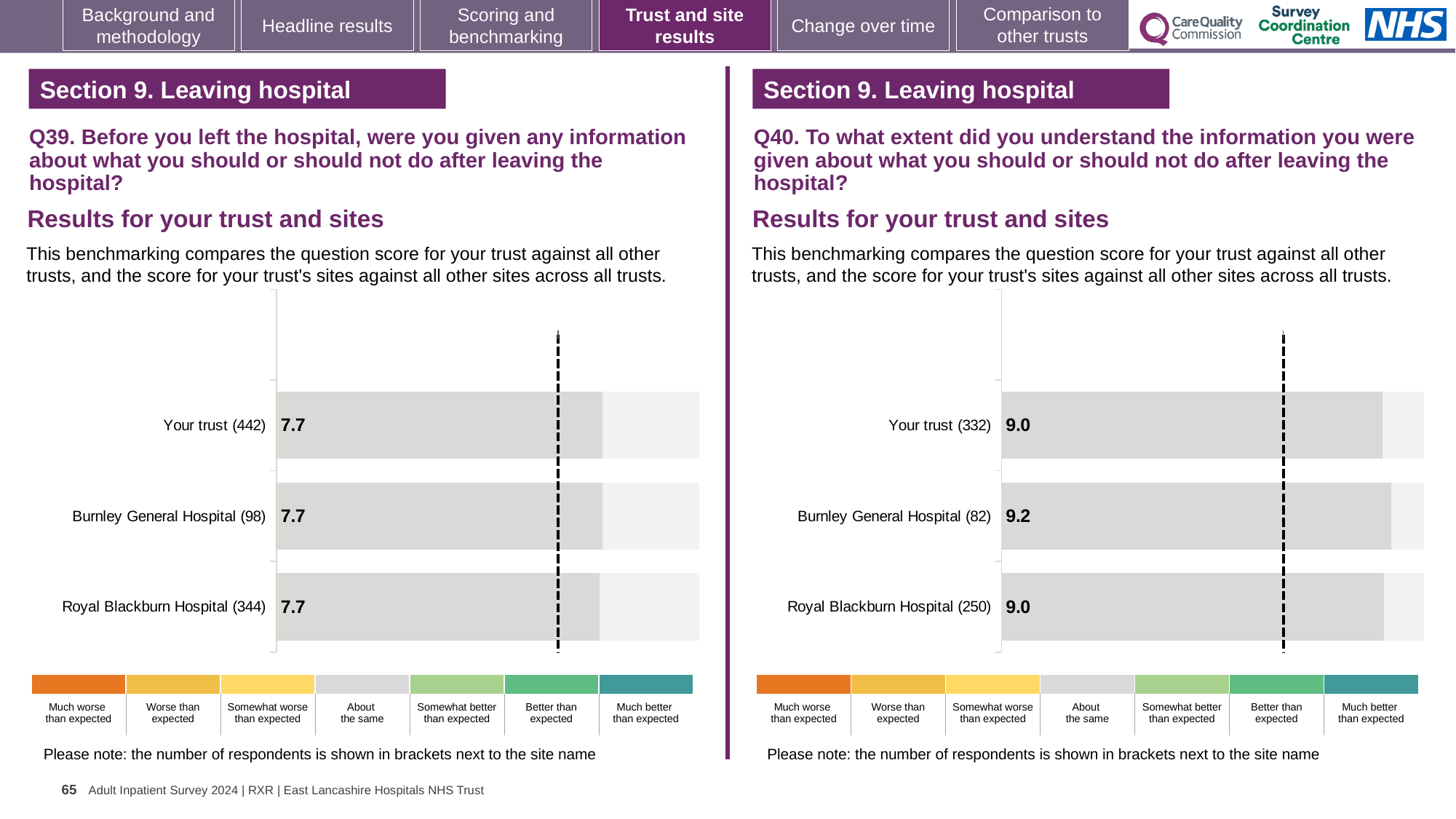
On the Q40 chart (right), how many respondents are shown in brackets for Royal Blackburn Hospital? 250 How many bars are shown on the Q39 chart (left)? 3 On the Q40 chart (right), what is the difference between the scores for Burnley General Hospital and Royal Blackburn Hospital? 0.2 On the Q39 chart (left), how many respondents are shown in brackets for Burnley General Hospital? 98 On the Q39 chart (left), do all three bars show the same score? Yes What type of chart is used on the Q40 chart (right)? Bar chart On the Q40 chart (right), what is the score for Burnley General Hospital? 9.2 On the Q39 chart (left), what is the score for Your trust? 7.7 On the Q40 chart (right), which site has the highest score? Burnley General Hospital On the Q39 chart (left), what is the score for Royal Blackburn Hospital? 7.7 On the Q40 chart (right), which is larger: the score for Burnley General Hospital or the score for Your trust? Burnley General Hospital On the Q40 chart (right), what is the score for Your trust? 9.0